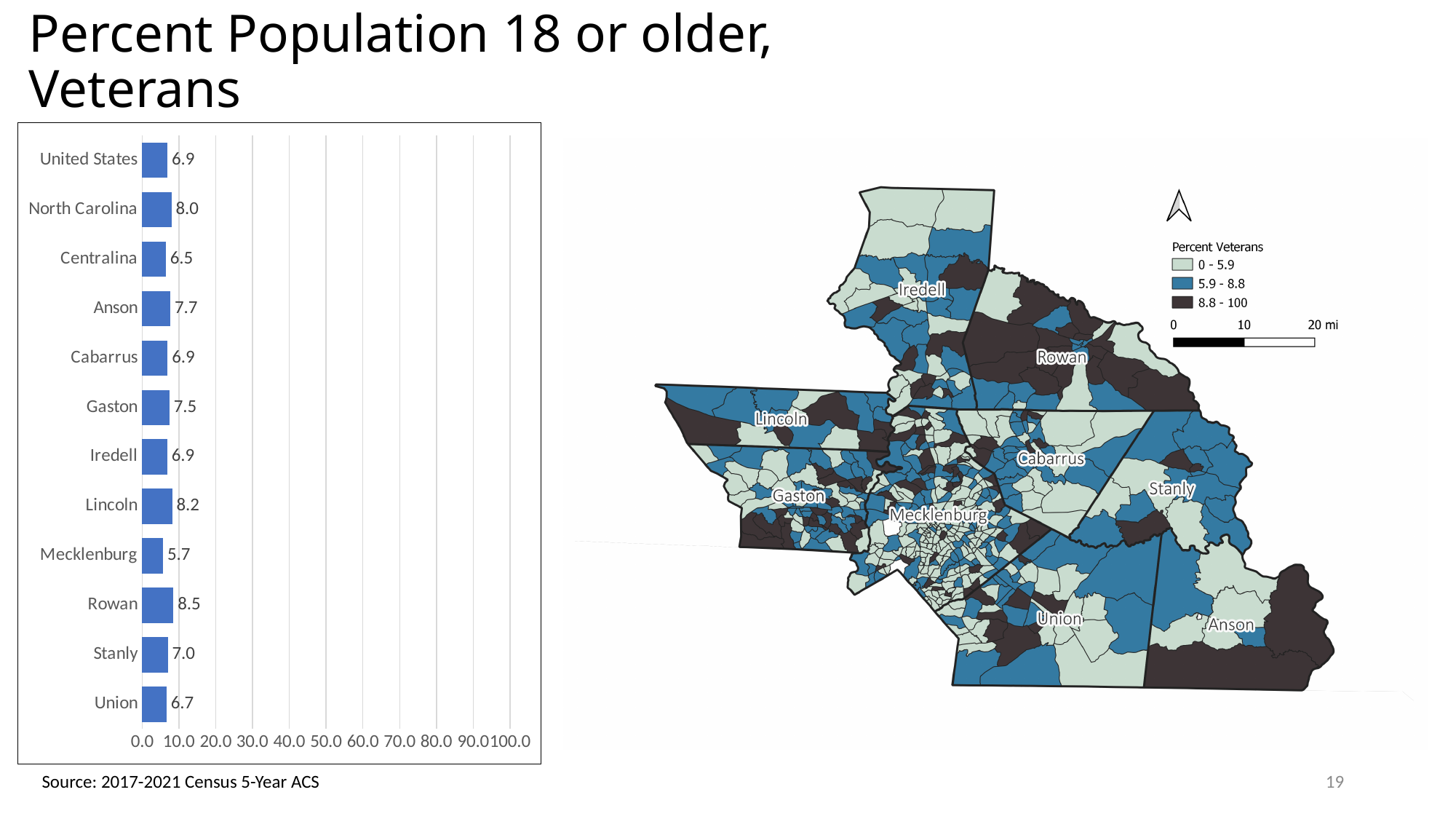
What is the difference between the values for Rowan and Mecklenburg in the bar chart? 2.8 What is the value for Rowan in the bar chart? 8.5 What is the value for North Carolina in the bar chart? 8.0 Which category has the highest value in the bar chart? Rowan What is the value for Mecklenburg in the bar chart? 5.7 What kind of chart is shown on the left of the slide? bar chart What is the difference between the values for North Carolina and United States in the bar chart? 1.1 In the bar chart, which is larger, the value for Anson or the value for Gaston? Anson What is the value for Lincoln in the bar chart? 8.2 Which category has the lowest value in the bar chart? Mecklenburg How many categories are shown in the bar chart? 12 Is the value for Stanly in the bar chart greater or less than 10.0? less